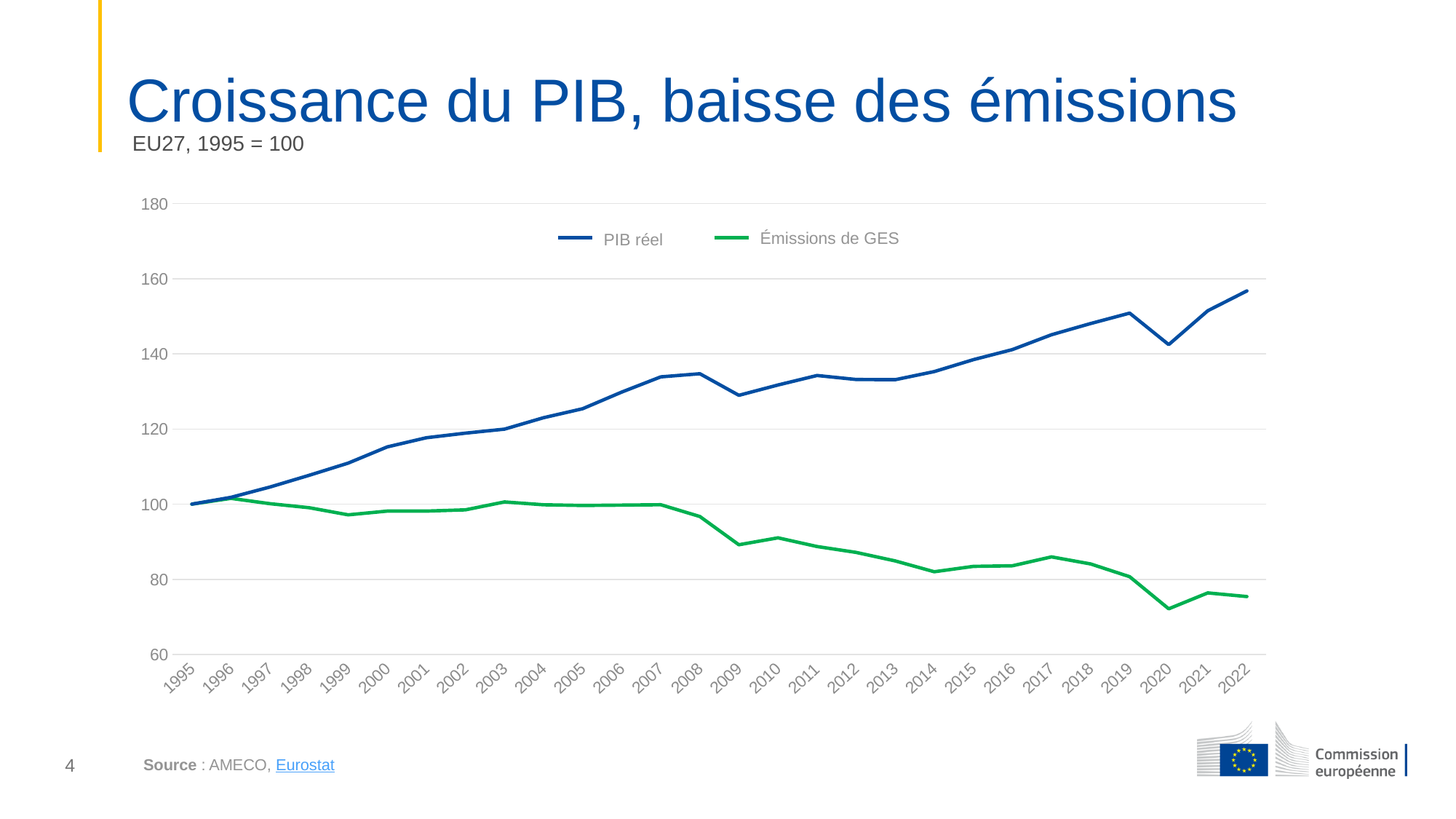
What is the value of PIB réel in 1995? 100 In which year does PIB réel reach its highest value? 2022 Is the value for Émissions de GES in 2020 greater or less than 80? less Is the value for Émissions de GES in 2014 greater or less than 90? less What kind of chart is shown on the slide? line chart In 2022, which series has the higher value, PIB réel or Émissions de GES? PIB réel Does the PIB réel series generally rise or fall from 1995 to 2022? rise How many years are plotted along the x axis? 28 Does the Émissions de GES series generally rise or fall from 1995 to 2022? fall Is the value for PIB réel in 2022 greater or less than 140? greater How many series does the legend list? 2 In which year does Émissions de GES reach its lowest value? 2020